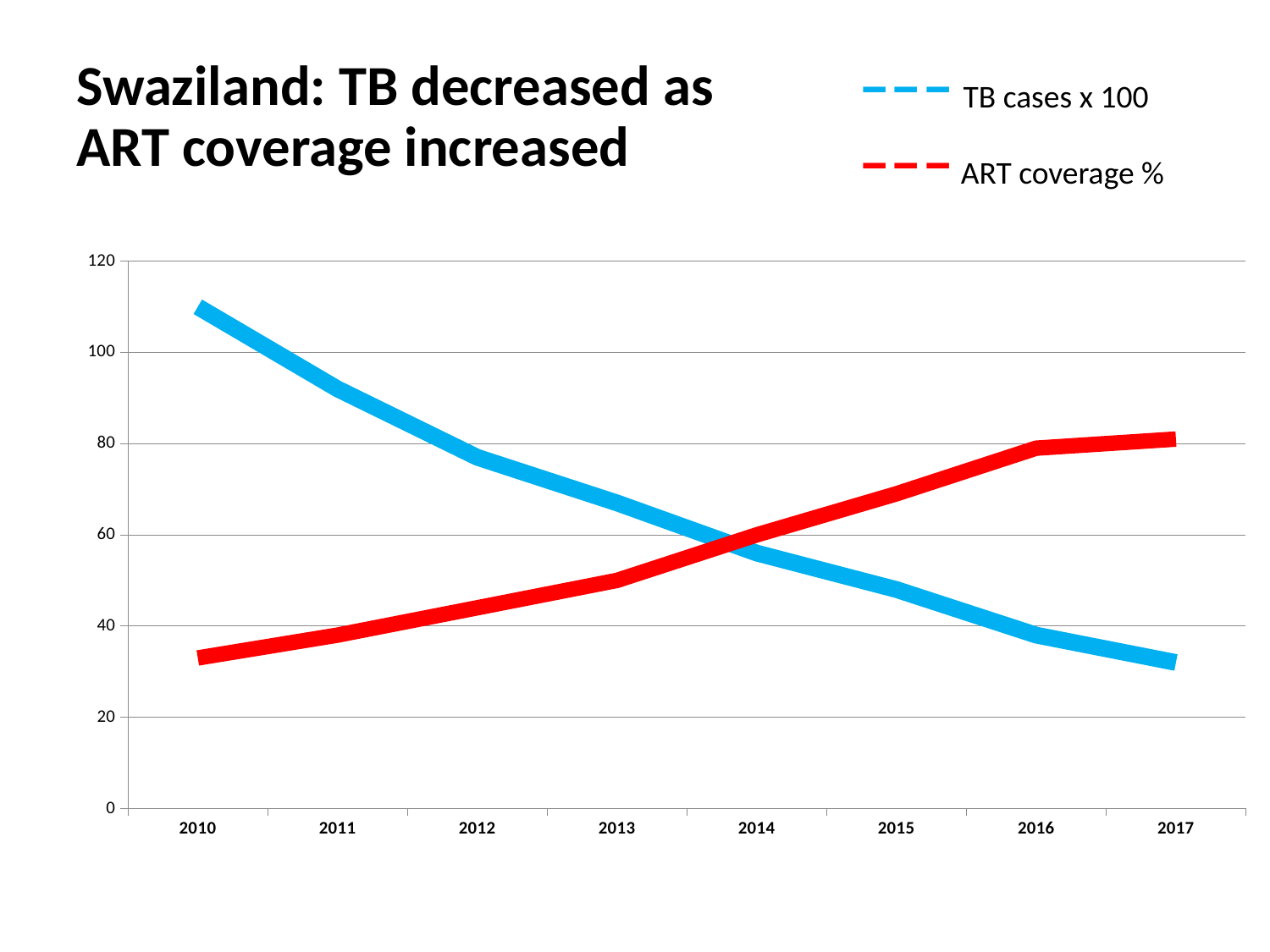
What kind of chart is shown on the slide? line chart Does the TB cases x 100 line rise or fall from 2010 to 2017? fall In which year is TB cases x 100 lowest? 2017 Does the ART coverage % line rise or fall from 2010 to 2017? rise Is the value for TB cases x 100 in 2010 greater or less than 100? greater In which year is TB cases x 100 highest? 2010 How many years are plotted along the x axis? 8 Is the value for ART coverage % in 2015 greater or less than 60? greater Which colour is used for the TB cases x 100 line? blue In 2017, which series has the larger value, TB cases x 100 or ART coverage %? ART coverage % How many series does the legend list? 2 In which year is ART coverage % lowest? 2010